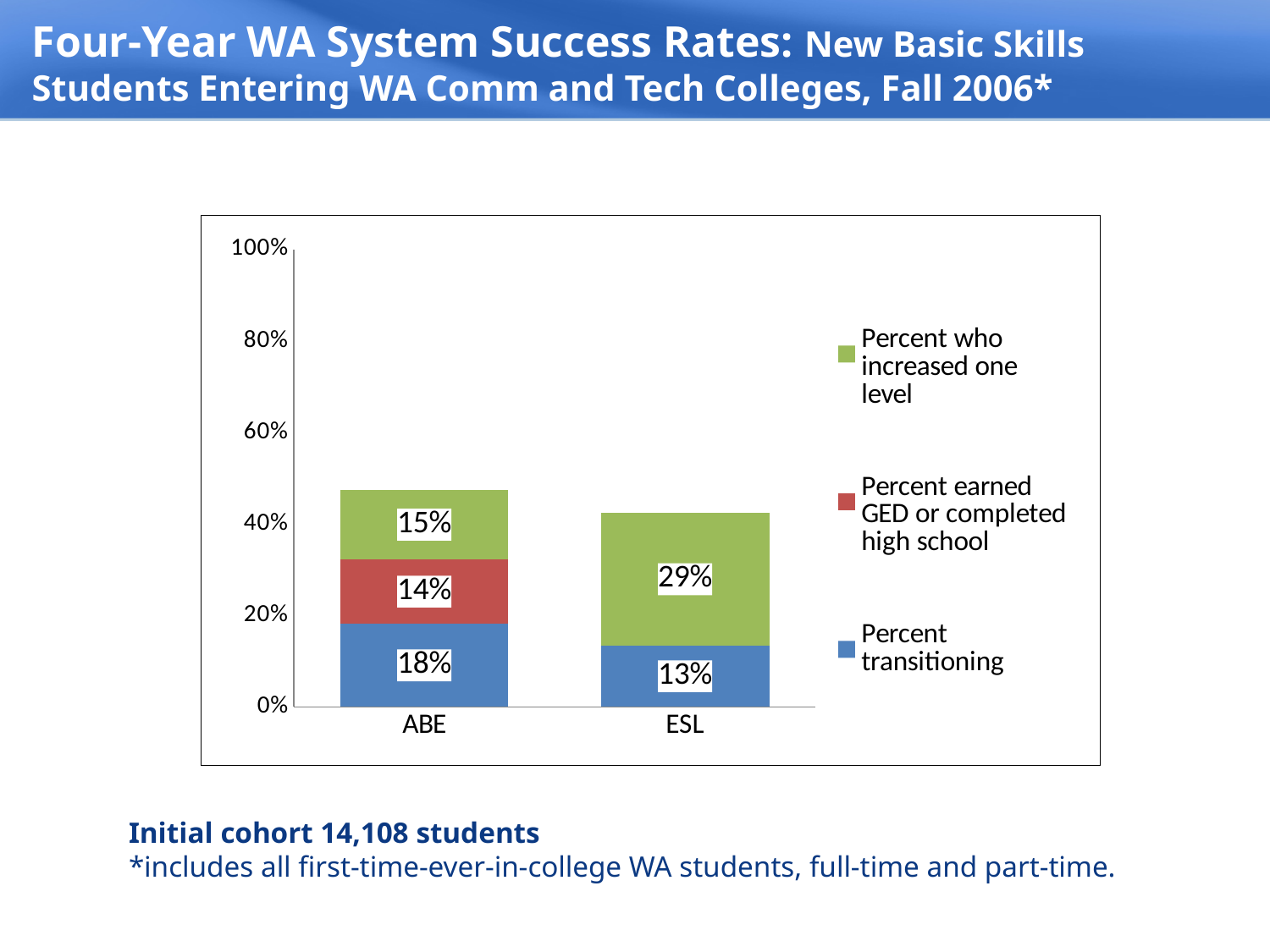
What is the value for 'Percent who increased one level' for ABE? 15% What type of chart is shown on the slide? Stacked bar chart What is the value for 'Percent who increased one level' for ESL? 29% Which category has the higher 'Percent who increased one level', ABE or ESL? ESL How many categories are shown on the x axis? 2 What is the value for 'Percent earned GED or completed high school' for ABE? 14% What is the value for 'Percent transitioning' for ESL? 13% Which series is shown in green in the legend? Percent who increased one level What is the value for 'Percent transitioning' for ABE? 18% How many series does the legend list? 3 What is the difference between the 'Percent transitioning' values for ABE and ESL? 5% What is the total of the stacked bar for ABE? 47%